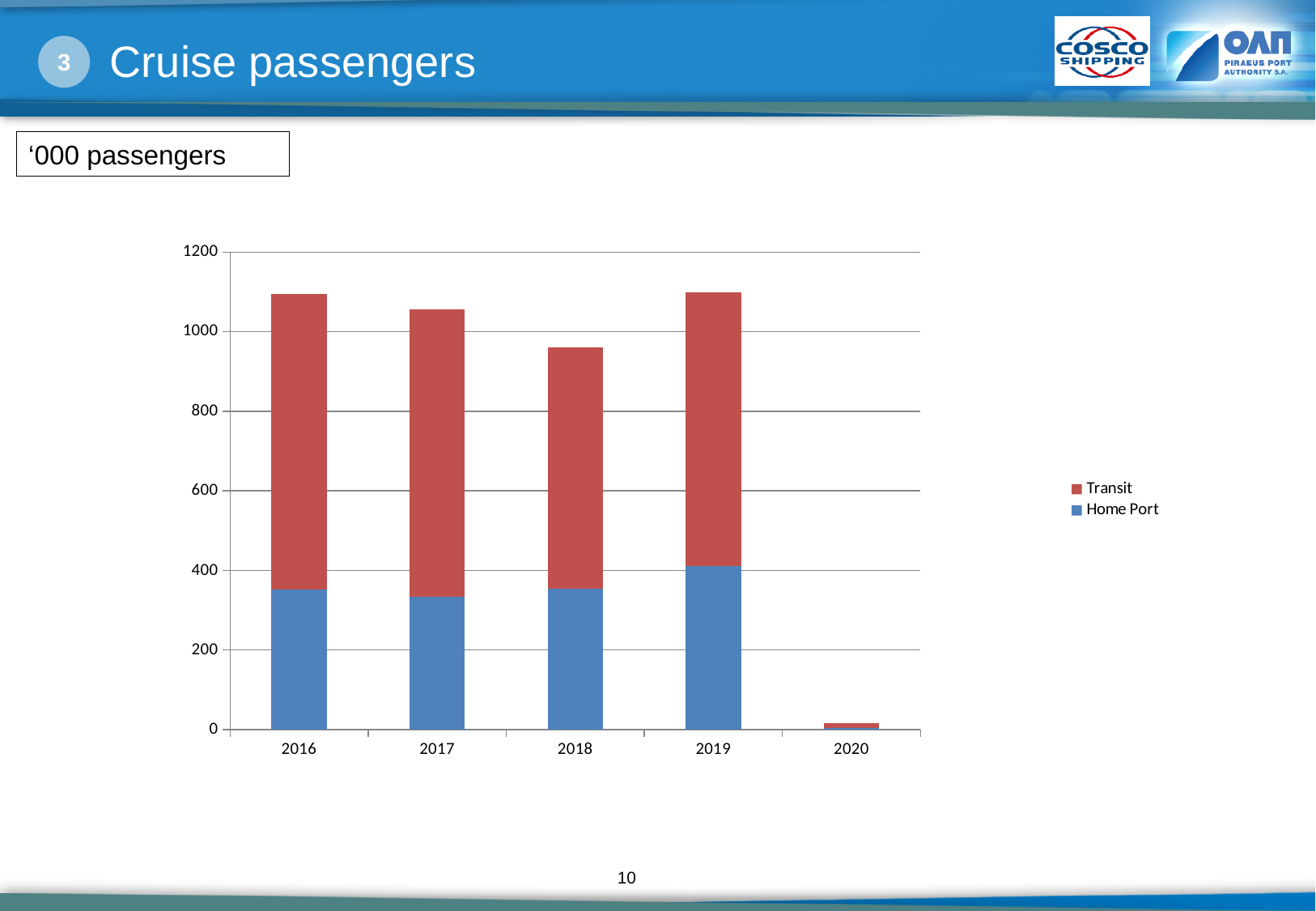
What unit is stated for the values in the chart? '000 passengers Is the total value for 2018 greater or less than 1000? less Which year has the larger total, 2018 or 2019? 2019 Is the Home Port value for 2017 greater or less than 400? less Is the total value for 2016 greater or less than 1000? greater Which series is shown in red? Transit Which year has the lowest total number of cruise passengers? 2020 How many series does the legend list? 2 What kind of chart is shown on the slide? Stacked bar chart How many years are shown on the x axis? 5